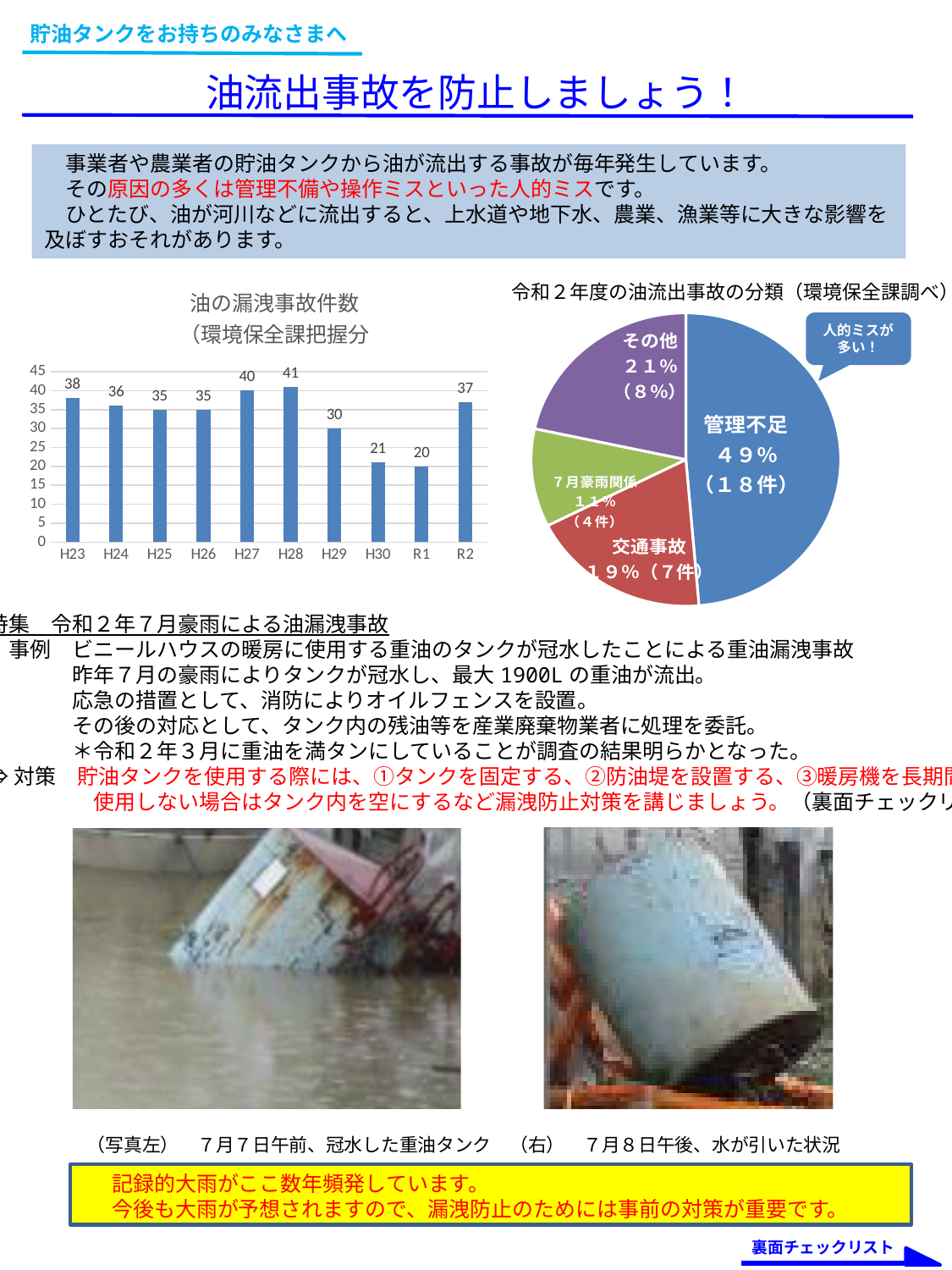
In the pie chart titled 令和２年度の油流出事故の分類, which slice is the smallest? 7月豪雨関係 In the pie chart titled 令和２年度の油流出事故の分類, what percentage share does 管理不足 have? 49% In the bar chart titled 油の漏洩事故件数, which is larger, the value for H29 or the value for H30? H29 In the bar chart titled 油の漏洩事故件数, what is the value for H28? 41 In the bar chart titled 油の漏洩事故件数, what is the difference between the values for R2 and R1? 17 In the bar chart titled 油の漏洩事故件数, which category has the lowest value? R1 In the pie chart titled 令和２年度の油流出事故の分類, how many slices are there? 4 In the bar chart titled 油の漏洩事故件数, what is the value for R1? 20 In the pie chart titled 令和２年度の油流出事故の分類, how many cases (件) are attributed to 交通事故? 7件 In the bar chart titled 油の漏洩事故件数, how many categories are shown on the x axis? 10 In the bar chart titled 油の漏洩事故件数, which category has the highest value? H28 What kind of chart is the chart titled 油の漏洩事故件数? bar chart